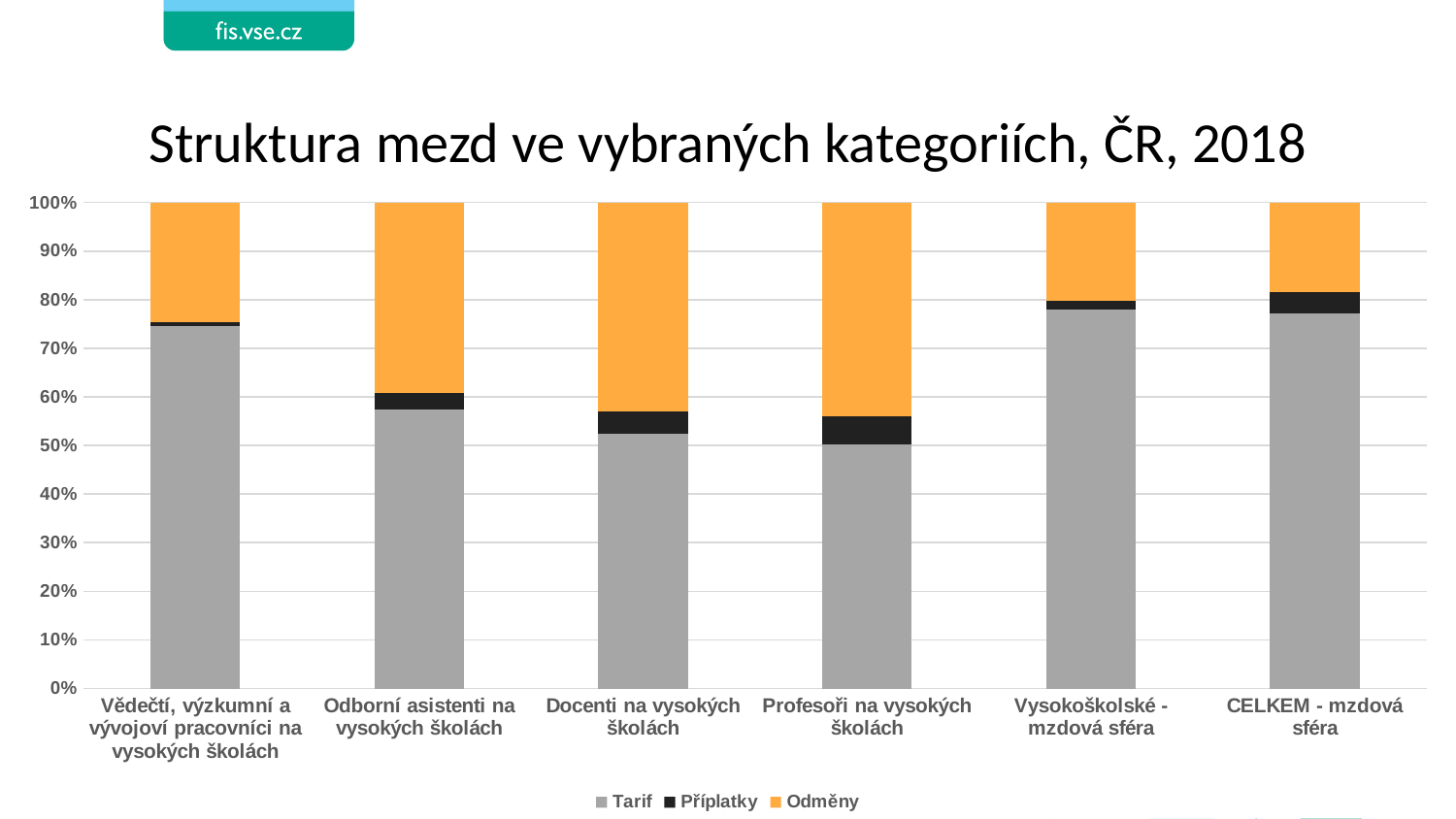
Which has a larger Odměny share: 'Odborní asistenti na vysokých školách' or 'Vysokoškolské - mzdová sféra'? Odborní asistenti na vysokých školách How many categories are shown on the x axis of the chart? 6 How many series does the legend list? 3 Is the Odměny share for 'Profesoři na vysokých školách' greater or less than 40%? greater Is the Tarif value for 'Vysokoškolské - mzdová sféra' greater or less than 70%? greater What is the title of the chart? Struktura mezd ve vybraných kategoriích, ČR, 2018 Is the Tarif value for 'Docenti na vysokých školách' greater or less than 60%? less Which series is shown in orange in the chart? Odměny What is the total height of the stacked bar for 'Profesoři na vysokých školách'? 100% Which has a larger Tarif share: 'Vědečtí, výzkumní a vývojoví pracovníci na vysokých školách' or 'Odborní asistenti na vysokých školách'? Vědečtí, výzkumní a vývojoví pracovníci na vysokých školách What kind of chart is shown on the slide? Stacked bar chart